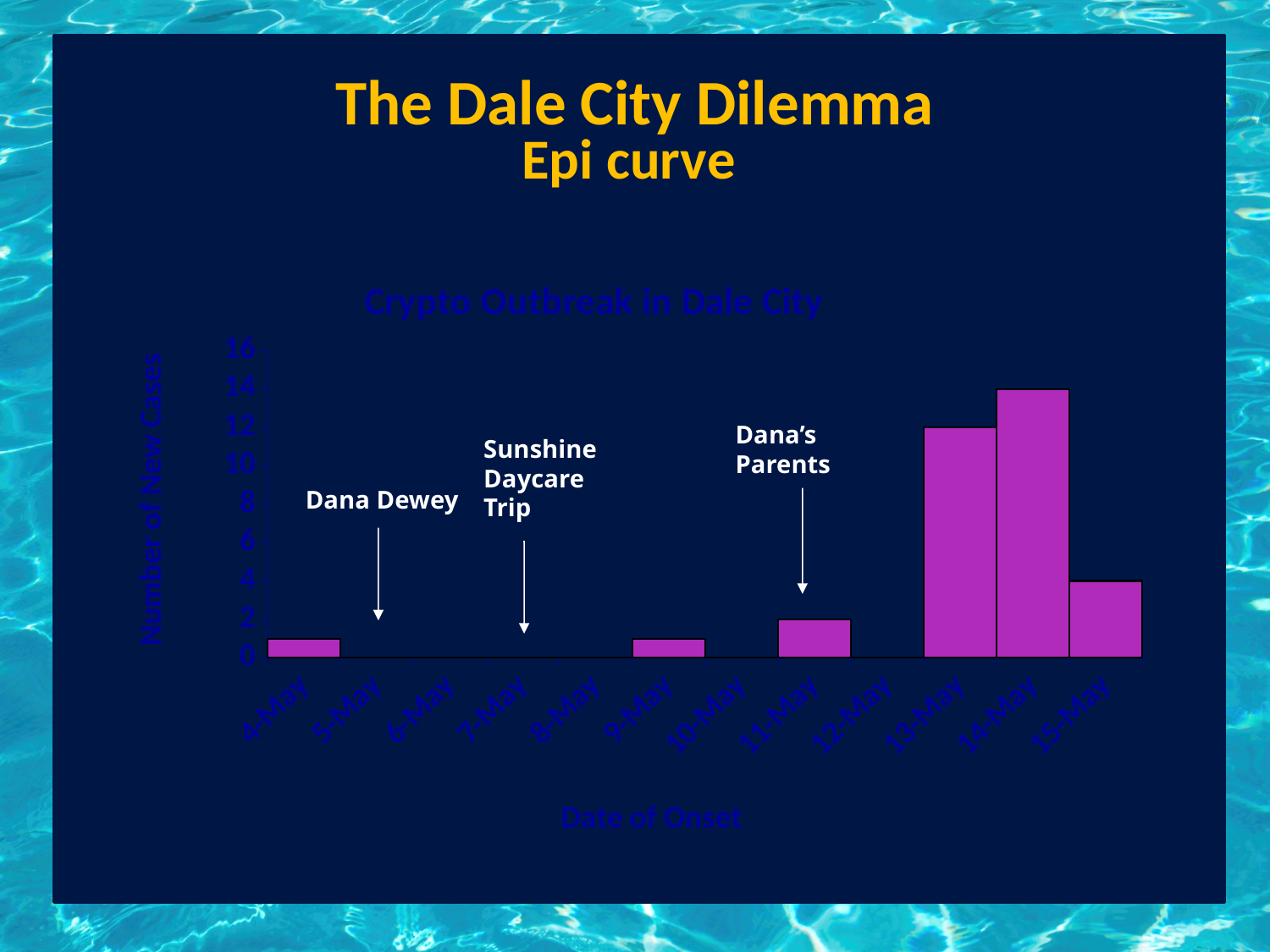
Is the number of new cases on 4-May greater or less than 2? less What is the number of new cases on 14-May? 14 How many dates of onset are shown on the x axis? 12 What is the difference in new cases between 13-May and 15-May? 8 How many more new cases were there on 14-May than on 13-May? 2 Which annotation label points to the bar on 11-May? Dana's Parents What kind of chart is shown on the slide? bar chart What is the number of new cases on 11-May? 2 What is the number of new cases on 15-May? 4 Which date has more new cases, 11-May or 15-May? 15-May Which date of onset has the highest number of new cases? 14-May What is the number of new cases on 13-May? 12